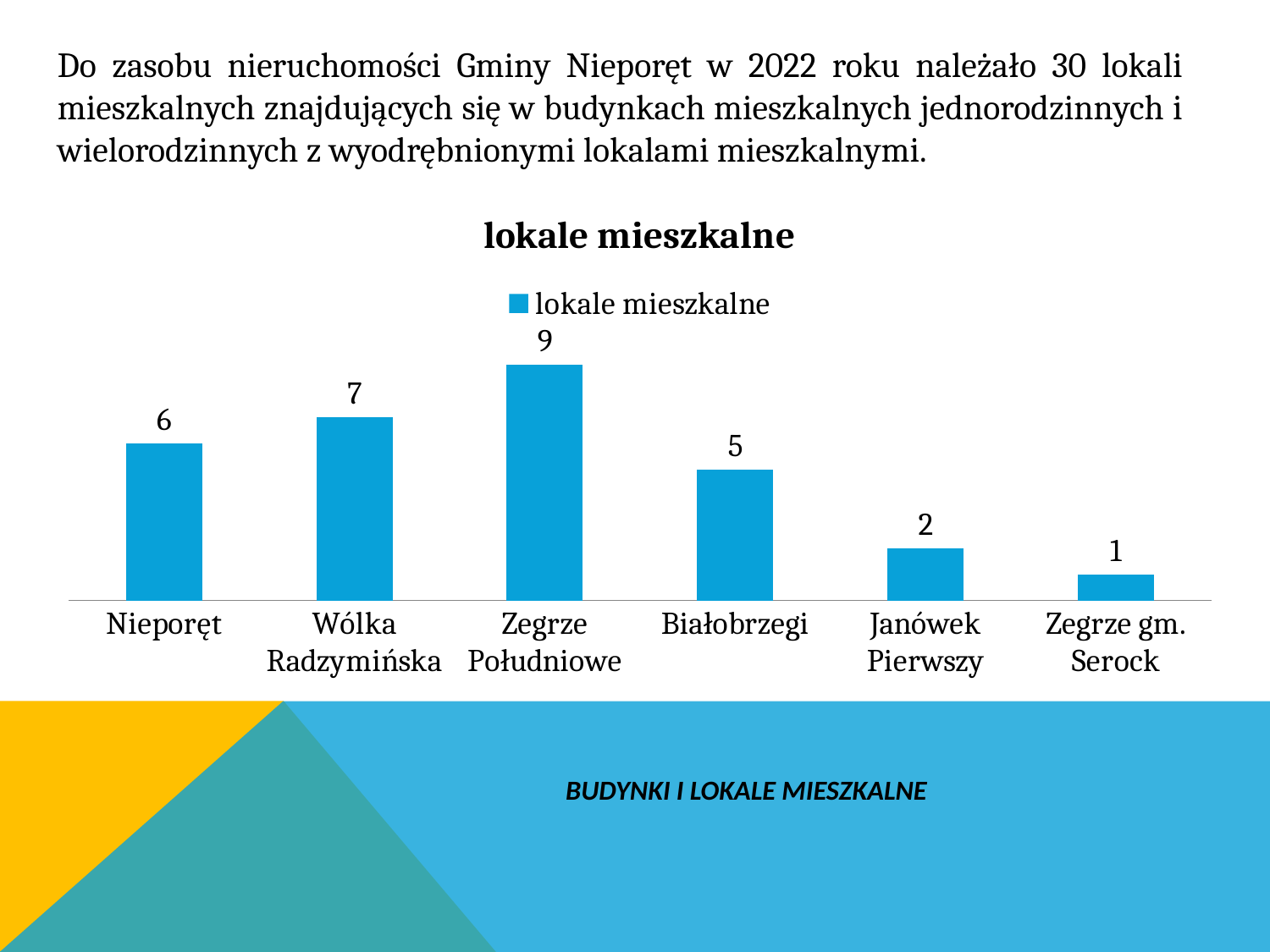
Which is larger, the value for Nieporęt or the value for Wólka Radzymińska? Wólka Radzymińska What is the difference between the values for Zegrze Południowe and Białobrzegi? 4 Which category has the highest value? Zegrze Południowe What is the title of the chart? lokale mieszkalne How many categories are shown on the x axis? 6 What is the value for Nieporęt? 6 What is the value for Białobrzegi? 5 Which category has the lowest value? Zegrze gm. Serock What is the value for Janówek Pierwszy? 2 What is the value for Wólka Radzymińska? 7 What kind of chart is shown? bar chart What is the value for Zegrze Południowe? 9